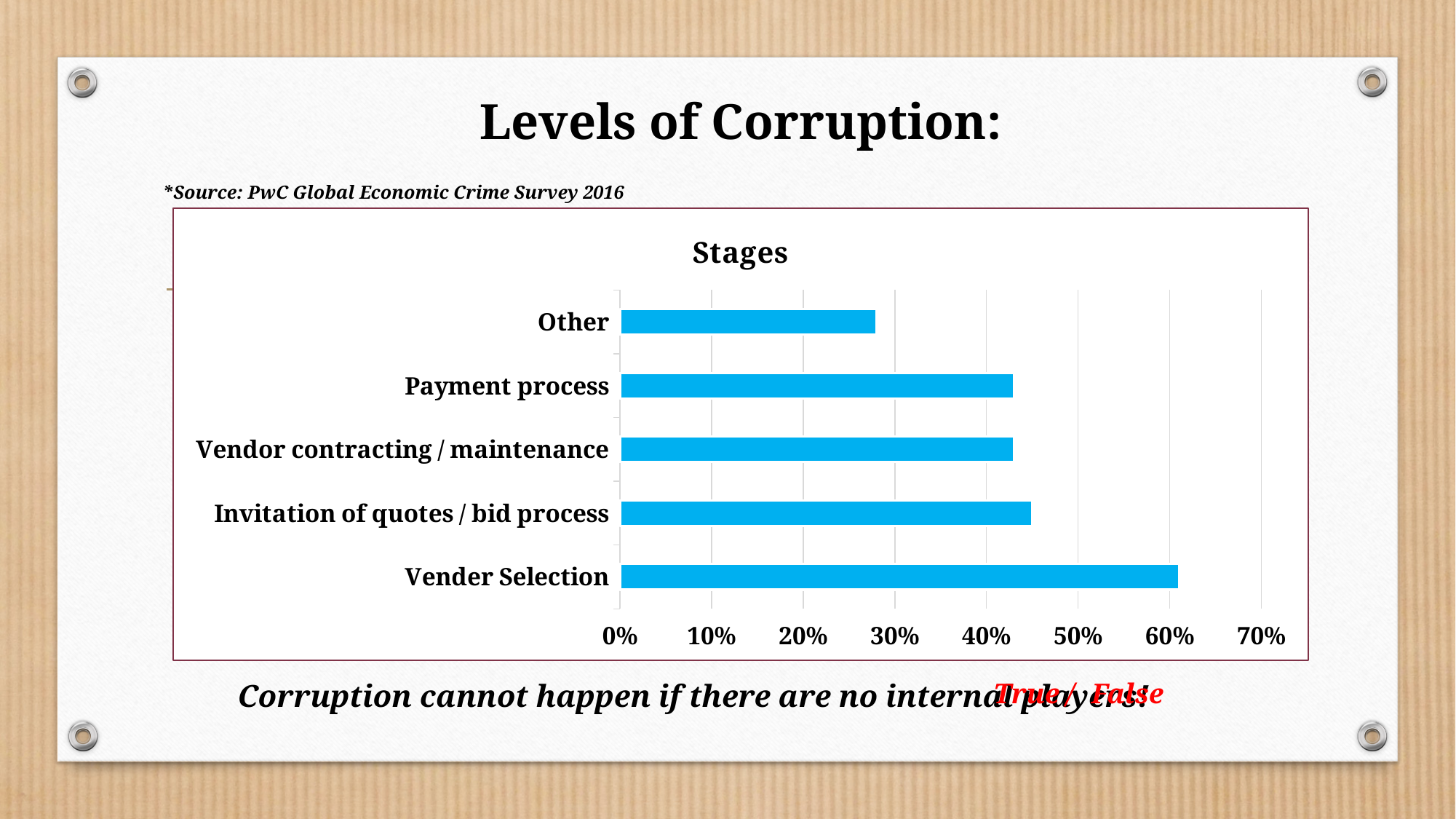
Is the value for Vender Selection greater or less than 60%? greater Which is larger, the value for Vender Selection or the value for Invitation of quotes / bid process? Vender Selection Which category has the lowest value? Other What is the highest value shown on the horizontal axis of the chart? 70% Which category has the highest value? Vender Selection How many categories are plotted in the chart? 5 Which is larger, the value for Other or the value for Payment process? Payment process What is the title of the chart? Stages Is the value for Payment process greater or less than 40%? greater What kind of chart is shown on the slide? bar chart Is the value for Other greater or less than 30%? less